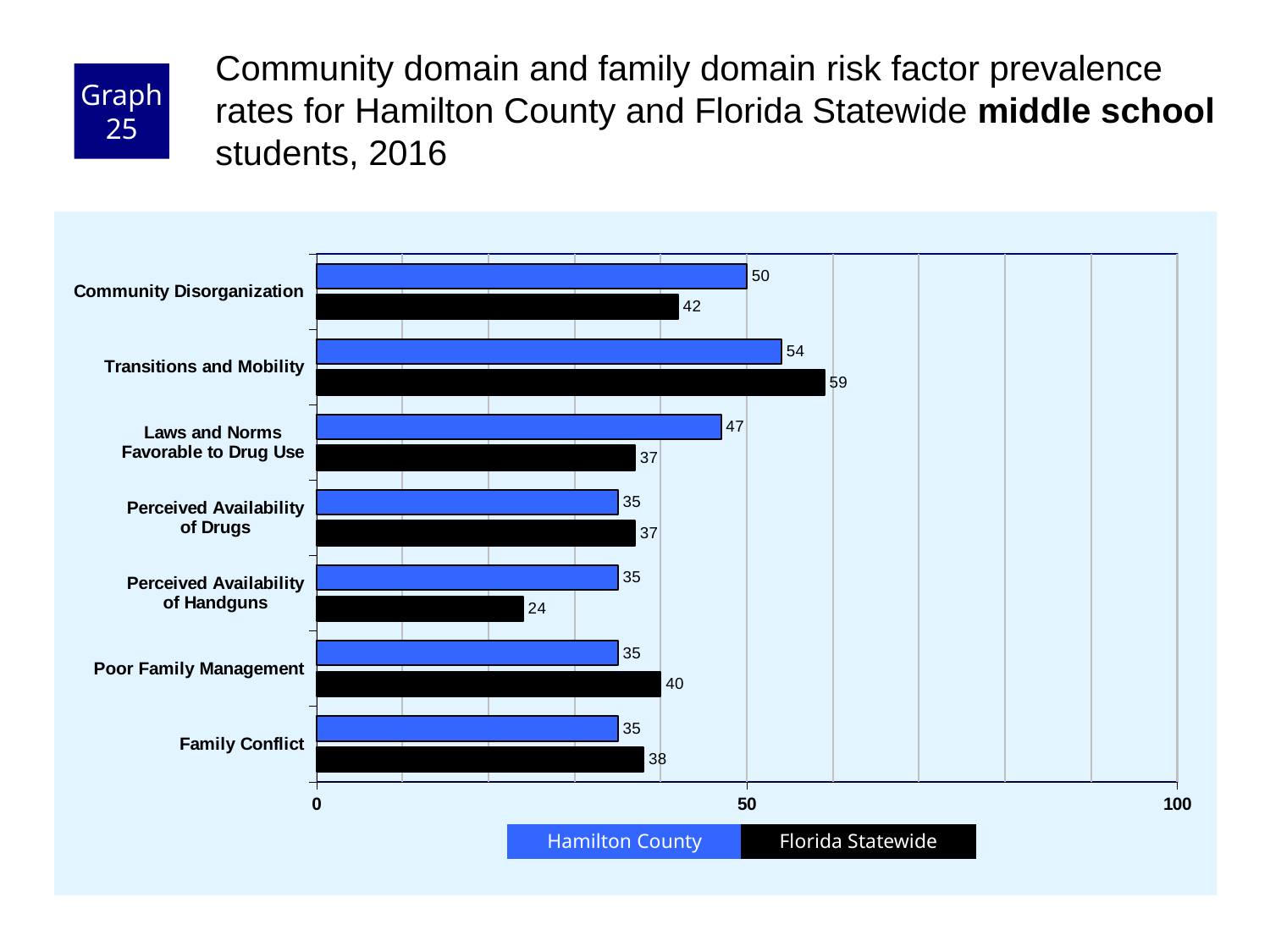
Which colour represents Florida Statewide in the chart? Black How many risk factor categories are shown on the chart? 7 How many series does the legend list? 2 Is the Florida Statewide value for Transitions and Mobility greater or less than 50? greater What is the Florida Statewide value for Transitions and Mobility? 59 What kind of chart is shown on the slide? Bar chart Which risk factor has the lowest Florida Statewide value? Perceived Availability of Handguns For Poor Family Management, which is larger: the Hamilton County value or the Florida Statewide value? Florida Statewide What is the difference between the Hamilton County and Florida Statewide values for Laws and Norms Favorable to Drug Use? 10 Which risk factor has the highest Hamilton County value? Transitions and Mobility What is the Florida Statewide value for Perceived Availability of Handguns? 24 What is the Hamilton County value for Community Disorganization? 50